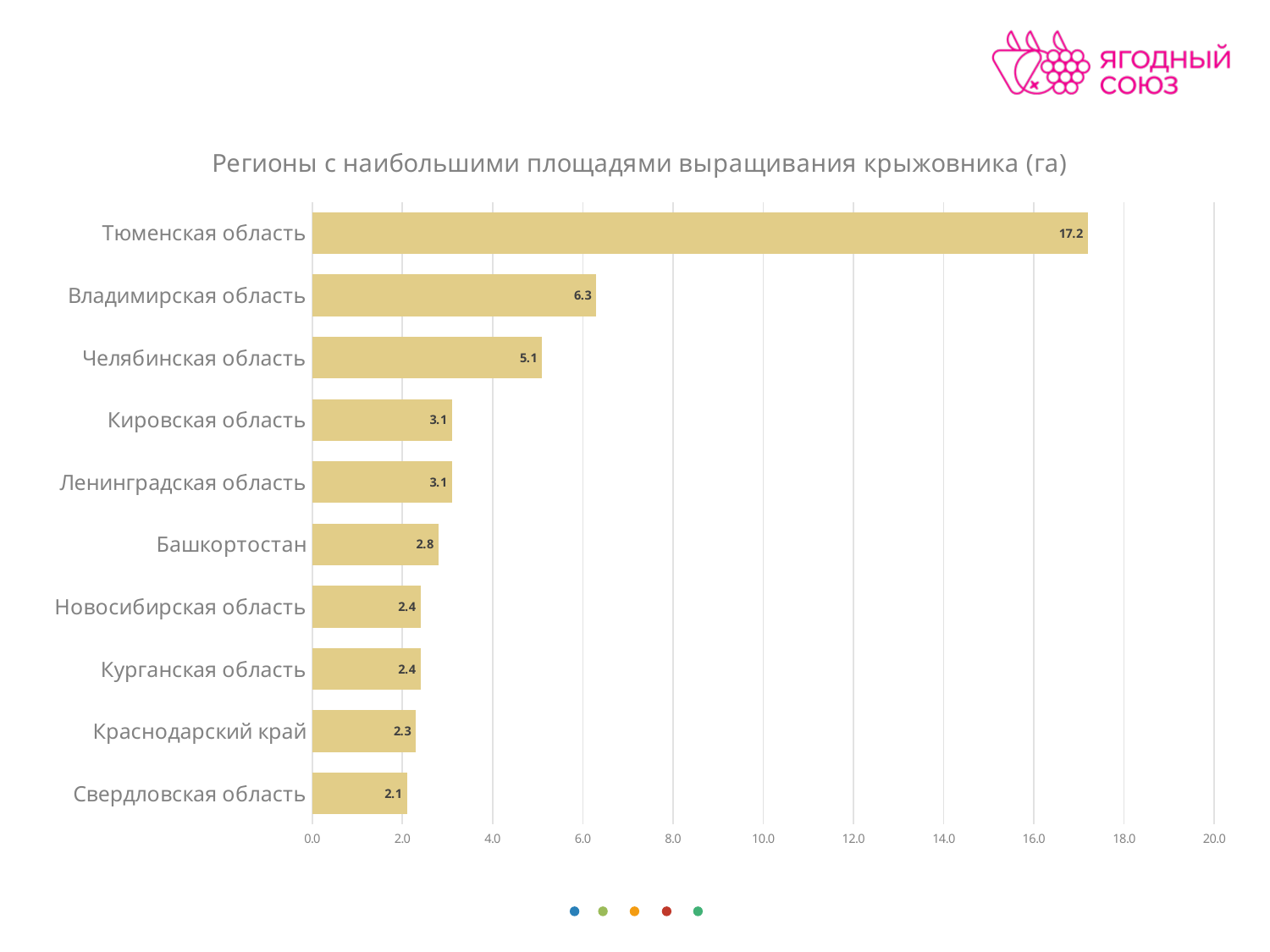
How many regions are shown in the chart? 10 Which region has the lowest value? Свердловская область What is the difference between the values for Челябинская область and Кировская область? 2.0 Which region has the highest value? Тюменская область Which is larger, the value for Владимирская область or the value for Челябинская область? Владимирская область What is the difference between the values for Тюменская область and Владимирская область? 10.9 What is the value for Башкортостан? 2.8 Is the value for Тюменская область greater or less than 16.0? greater What is the value for Тюменская область? 17.2 What is the title of the chart? Регионы с наибольшими площадями выращивания крыжовника (га) What is the value for Челябинская область? 5.1 What kind of chart is shown on the slide? bar chart